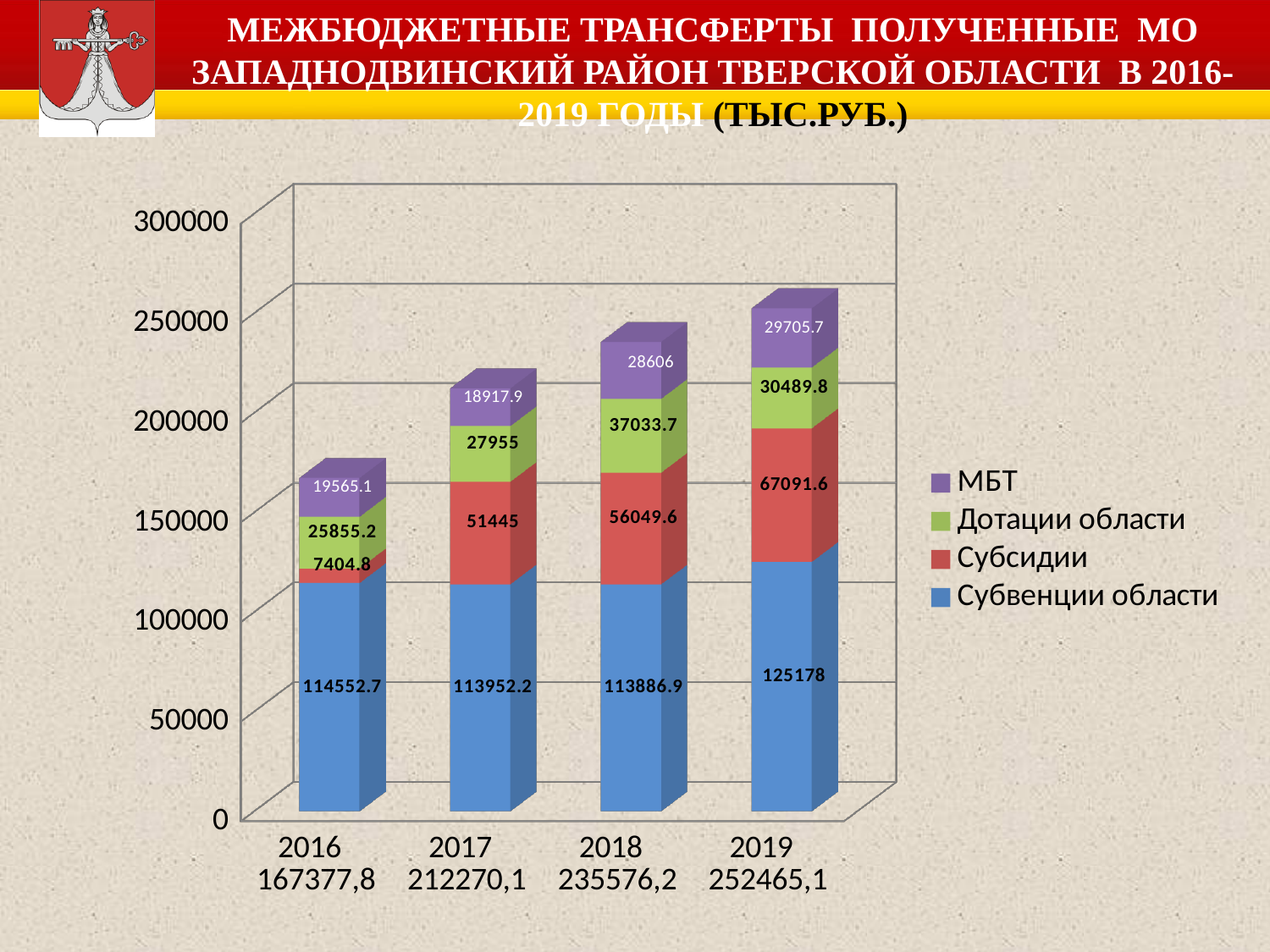
In which year is the Субсидии value the lowest? 2016 What is the total of the stacked bar for 2018? 235576,2 What is the value of Субсидии for 2019? 67091.6 What is the difference between the Субсидии values for 2019 and 2018? 11042 What kind of chart is shown on the slide? Stacked bar chart What is the value of МБТ for 2017? 18917.9 How many years are shown on the x axis? 4 How many series does the legend list? 4 Which is larger: Дотации области in 2017 or Дотации области in 2019? Дотации области in 2019 In which year is the МБТ value the highest? 2019 What is the value of Субвенции области for 2016? 114552.7 What is the value of Дотации области for 2018? 37033.7